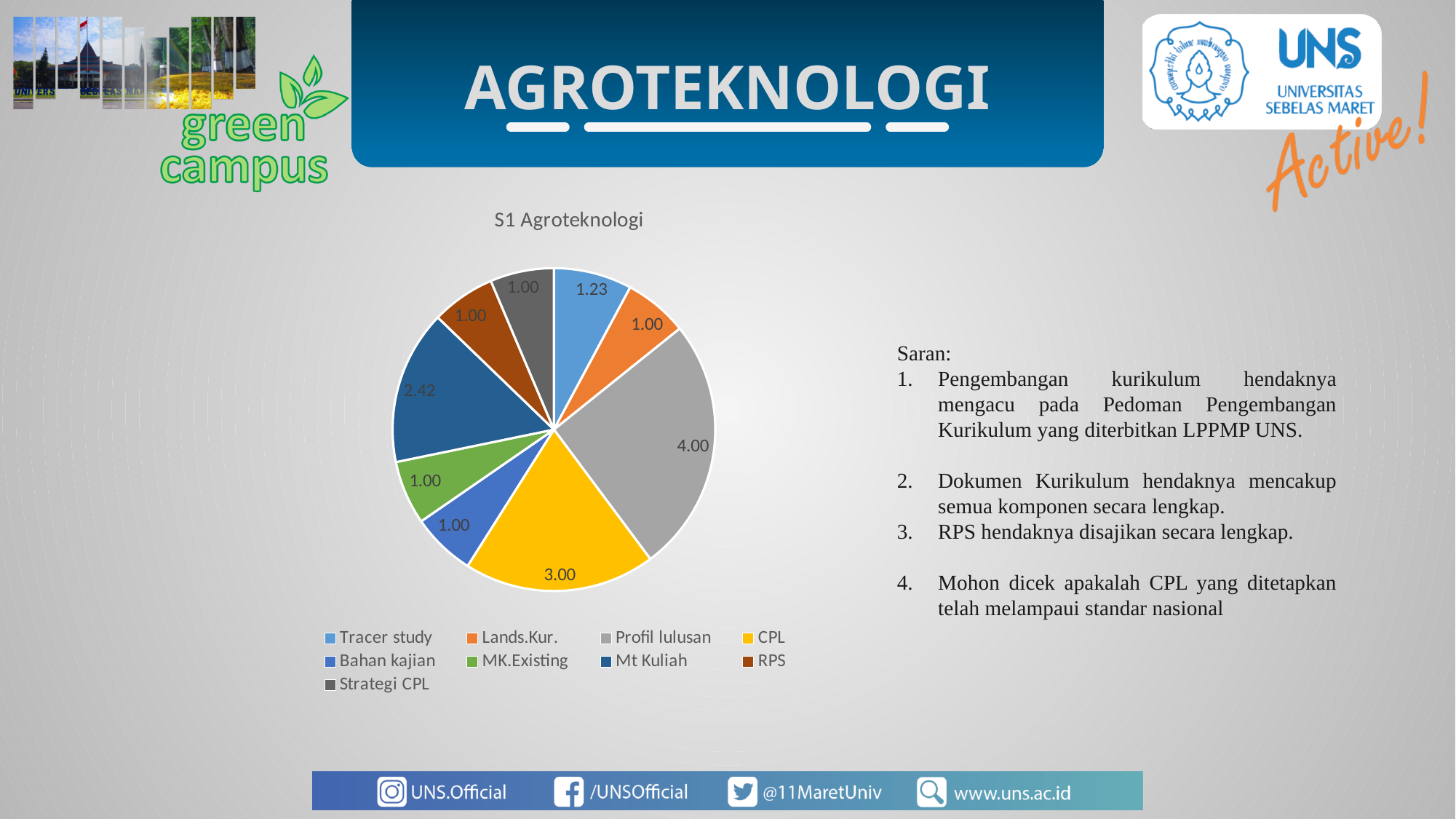
How many categories does the pie chart show? 9 What type of chart is shown on the slide? Pie chart What is the difference between the Mt Kuliah and Tracer study values in the pie chart? 1.19 What is the value of the Mt Kuliah slice in the pie chart? 2.42 What is the title of the chart on the slide? S1 Agroteknologi What is the value of the CPL slice in the pie chart? 3.00 What is the value of the Profil lulusan slice in the pie chart? 4.00 Which category has the largest slice in the pie chart? Profil lulusan What is the difference between the Profil lulusan and CPL values in the pie chart? 1.00 What is the value of the Tracer study slice in the pie chart? 1.23 What is the value of the RPS slice in the pie chart? 1.00 Which is larger in the pie chart, the CPL slice or the Mt Kuliah slice? CPL